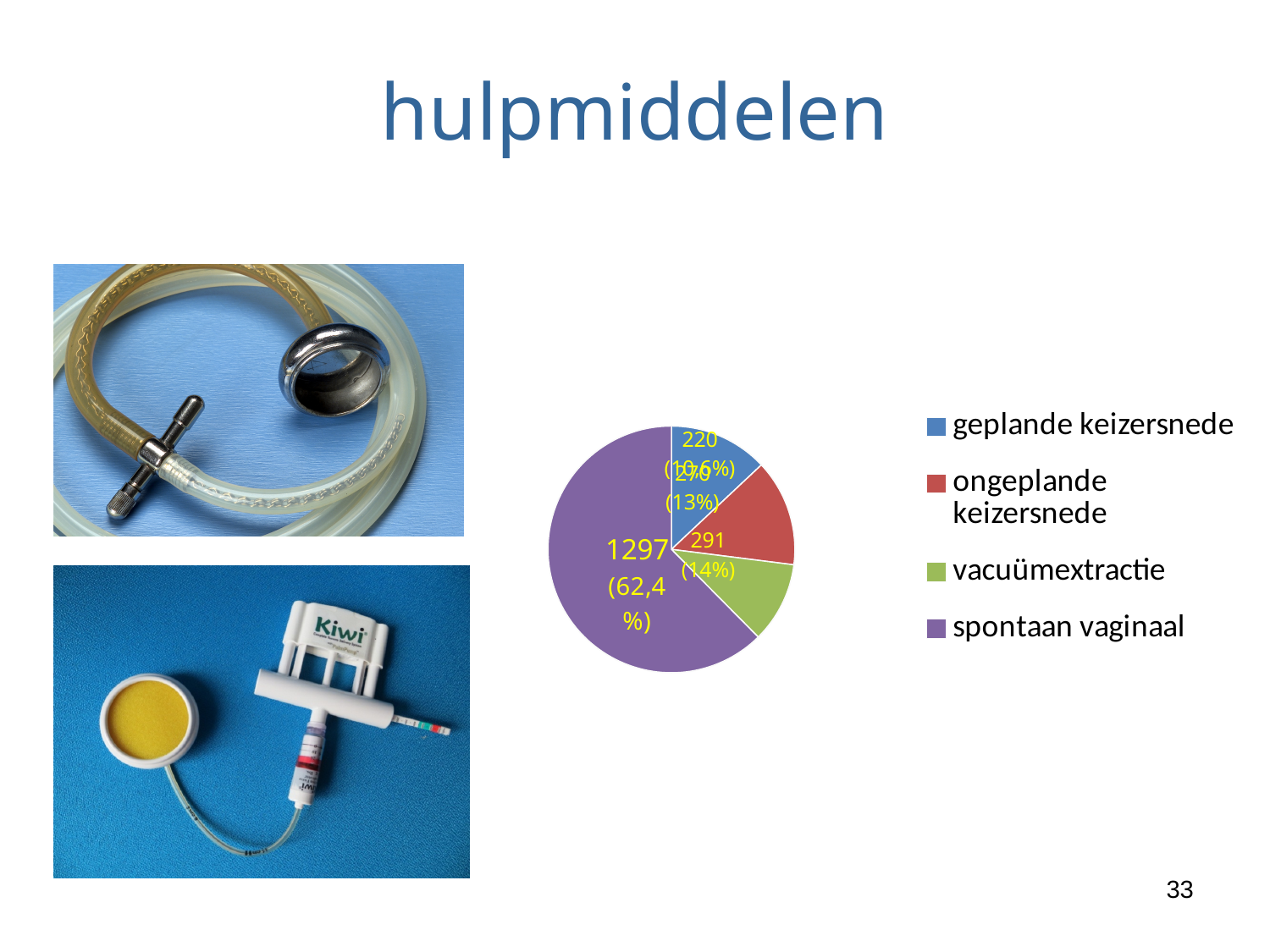
Which category has the smallest slice in the pie chart? vacuümextractie What is the value shown for spontaan vaginaal in the pie chart? 1297 What is the difference between the values for spontaan vaginaal and geplande keizersnede? 1027 What percentage share does spontaan vaginaal have in the pie chart? 62,4% What is the value shown for geplande keizersnede in the pie chart? 270 How many entries does the legend of the pie chart list? 4 What kind of chart is shown on the slide? pie chart Which is larger in the pie chart, spontaan vaginaal or geplande keizersnede? spontaan vaginaal How many slices does the pie chart have? 4 Which colour represents vacuümextractie in the pie chart legend? green What percentage share does geplande keizersnede have in the pie chart? 13% Which category has the largest slice in the pie chart? spontaan vaginaal